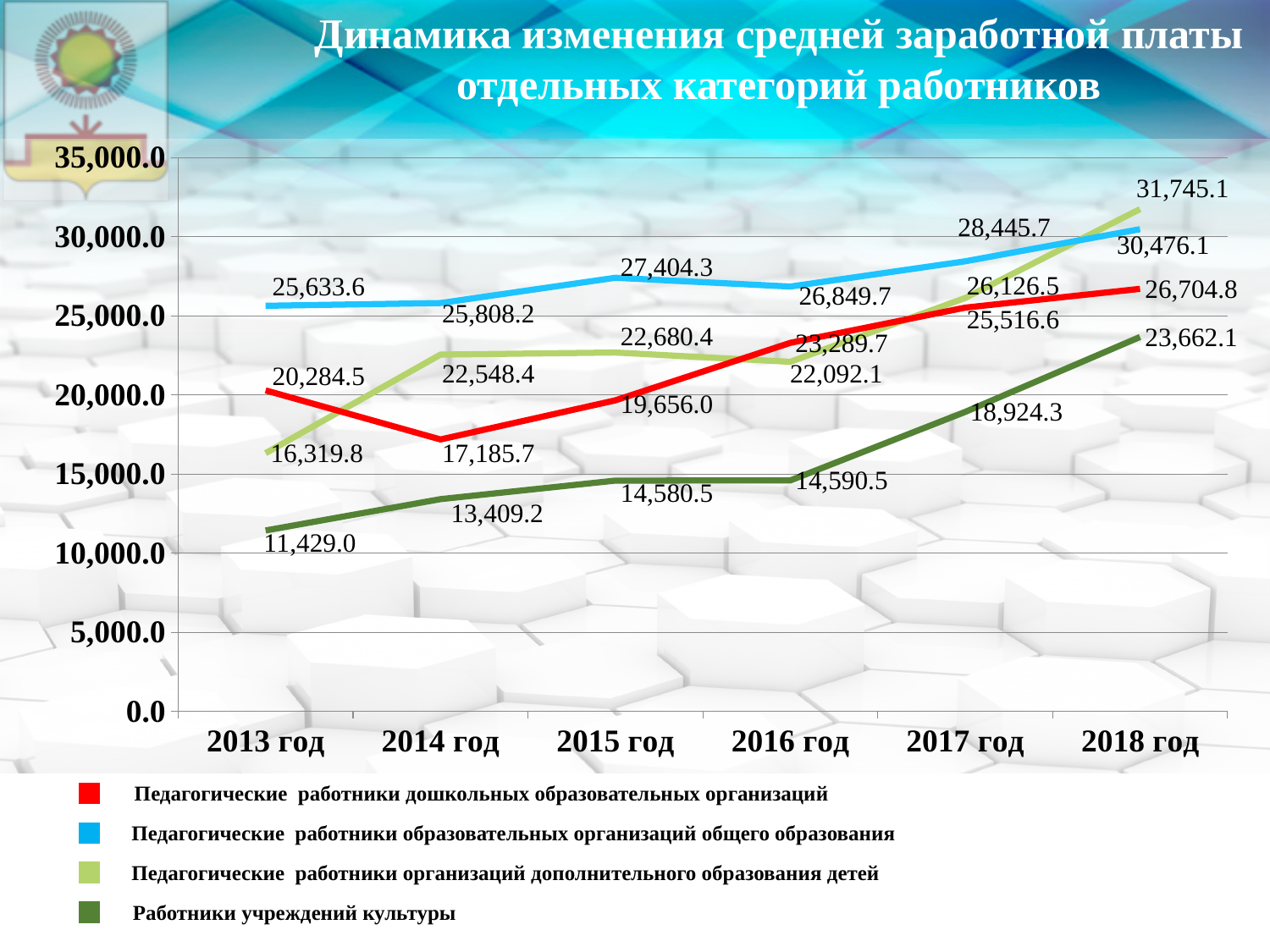
Which series has the lowest value in 2016 год? Работники учреждений культуры In 2017 год, which is larger: the value for Педагогические работники дошкольных образовательных организаций or for Педагогические работники организаций дополнительного образования детей? Педагогические работники организаций дополнительного образования детей Does the value for Работники учреждений культуры rise or fall from 2013 год to 2018 год? Rise How many years are shown on the x axis? 6 What is the value for Педагогические работники организаций дополнительного образования детей in 2018 год? 31,745.1 Which series has the highest value in 2018 год? Педагогические работники организаций дополнительного образования детей What is the value for Педагогические работники образовательных организаций общего образования in 2015 год? 27,404.3 What is the difference between the 2018 год and 2013 год values for Работники учреждений культуры? 12,233.1 What is the value for Работники учреждений культуры in 2013 год? 11,429.0 What kind of chart is shown on the slide? Line chart What is the value for Педагогические работники дошкольных образовательных организаций in 2014 год? 17,185.7 How many series does the legend list? 4